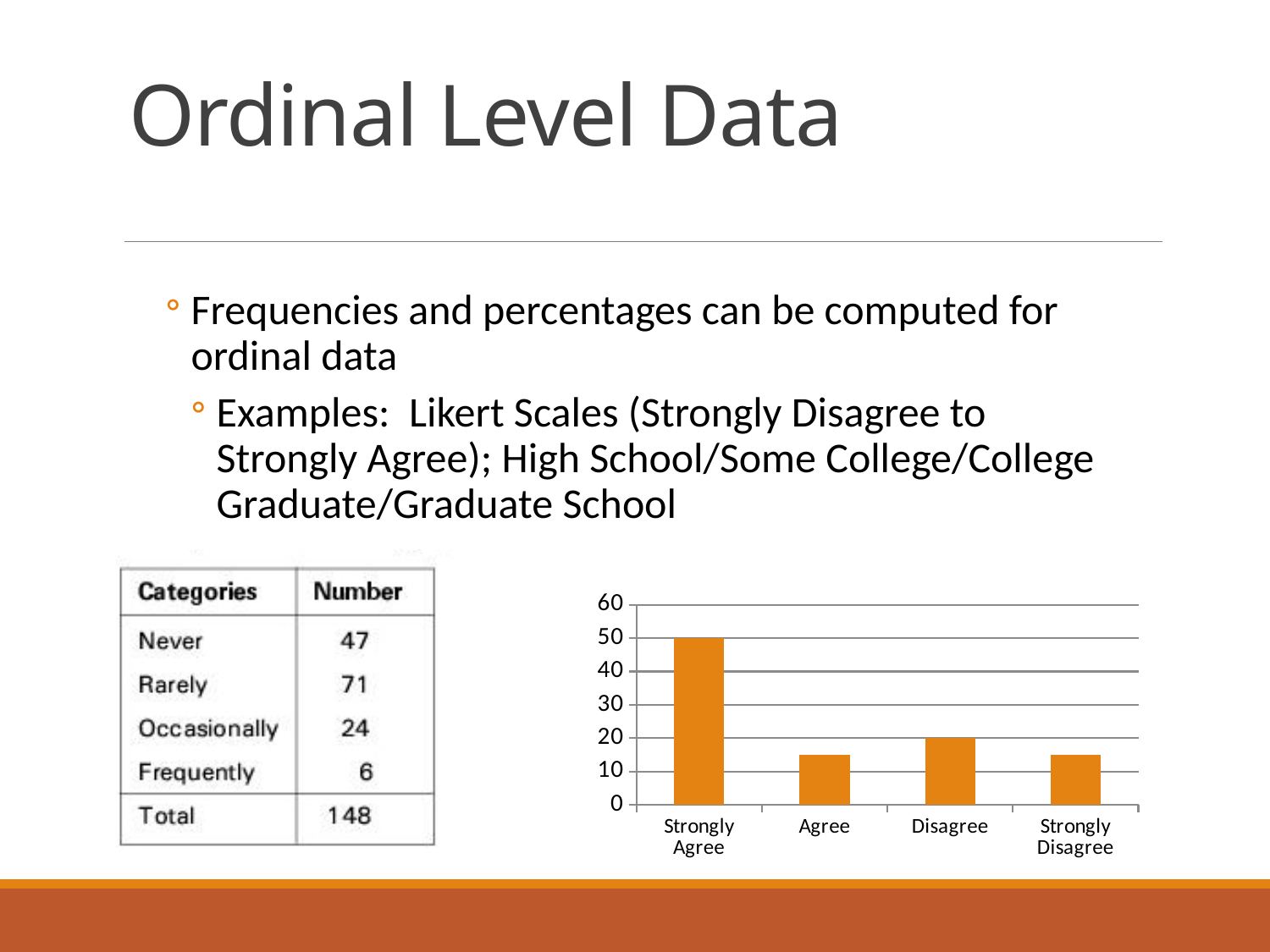
Which is larger, the bar for Disagree or the bar for Agree? Disagree Which is larger, the bar for Strongly Agree or the bar for Disagree? Strongly Agree Is the value for Agree greater or less than 20? less Is the value for Strongly Agree greater or less than 40? greater What is the value of the bar for Strongly Agree? 50 What is the highest value shown on the chart's vertical axis? 60 What kind of chart is shown on the slide? bar chart What is the value of the bar for Disagree? 20 What is the difference between the values for Strongly Agree and Disagree? 30 How many categories are shown on the x axis of the bar chart? 4 Is the value for Strongly Disagree greater or less than 10? greater Which category has the highest bar in the chart? Strongly Agree